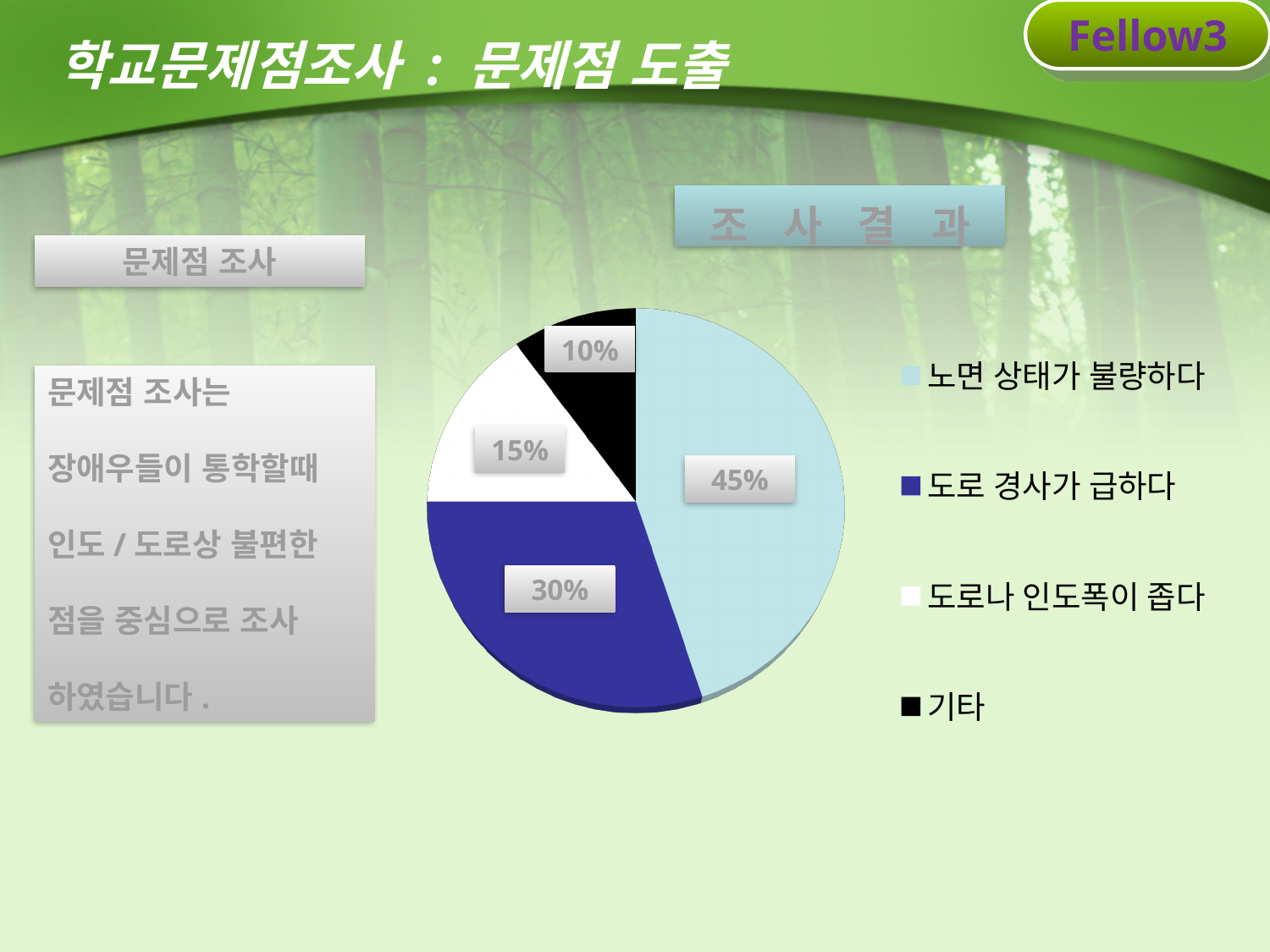
What percentage of the pie is labelled for 도로 경사가 급하다? 30% What percentage of the pie is labelled for 기타? 10% What percentage of the pie is labelled for 노면 상태가 불량하다? 45% What is the difference in percentage points between 노면 상태가 불량하다 and 도로 경사가 급하다? 15 What colour is the slice for 기타? black What kind of chart is shown on the slide? pie chart How many entries does the legend list? 4 Which category has the largest share of the pie? 노면 상태가 불량하다 What percentage of the pie is labelled for 도로나 인도폭이 좁다? 15% How many slices does the pie chart have? 4 Which category has the smallest share of the pie? 기타 Which is larger: the share for 도로나 인도폭이 좁다 or the share for 기타? 도로나 인도폭이 좁다